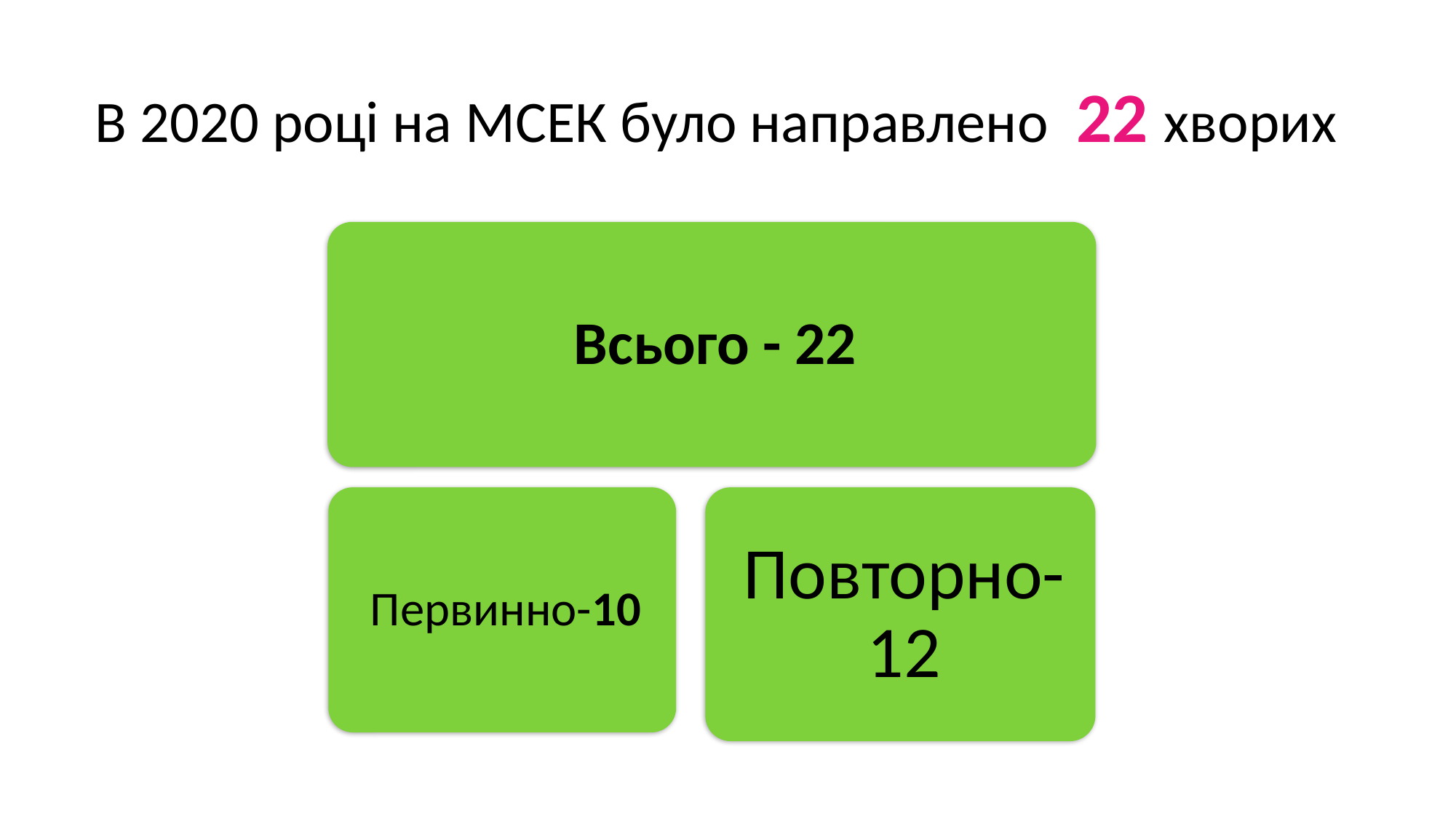
What is the sum of the values for Первинно and Повторно? 22 What total (Всього) is shown in the top box of the diagram? 22 Which of the two lower categories has the smaller value? Первинно What is the value shown for Первинно in the diagram? 10 What is the difference between the values for Повторно and Первинно? 2 According to the slide title, how many patients were referred to МСЕК in 2020? 22 How many boxes are in the bottom row of the diagram? 2 Which is larger, the value for Первинно or the value for Повторно? Повторно What colour are the boxes in the diagram? Green What is the value shown for Повторно in the diagram? 12